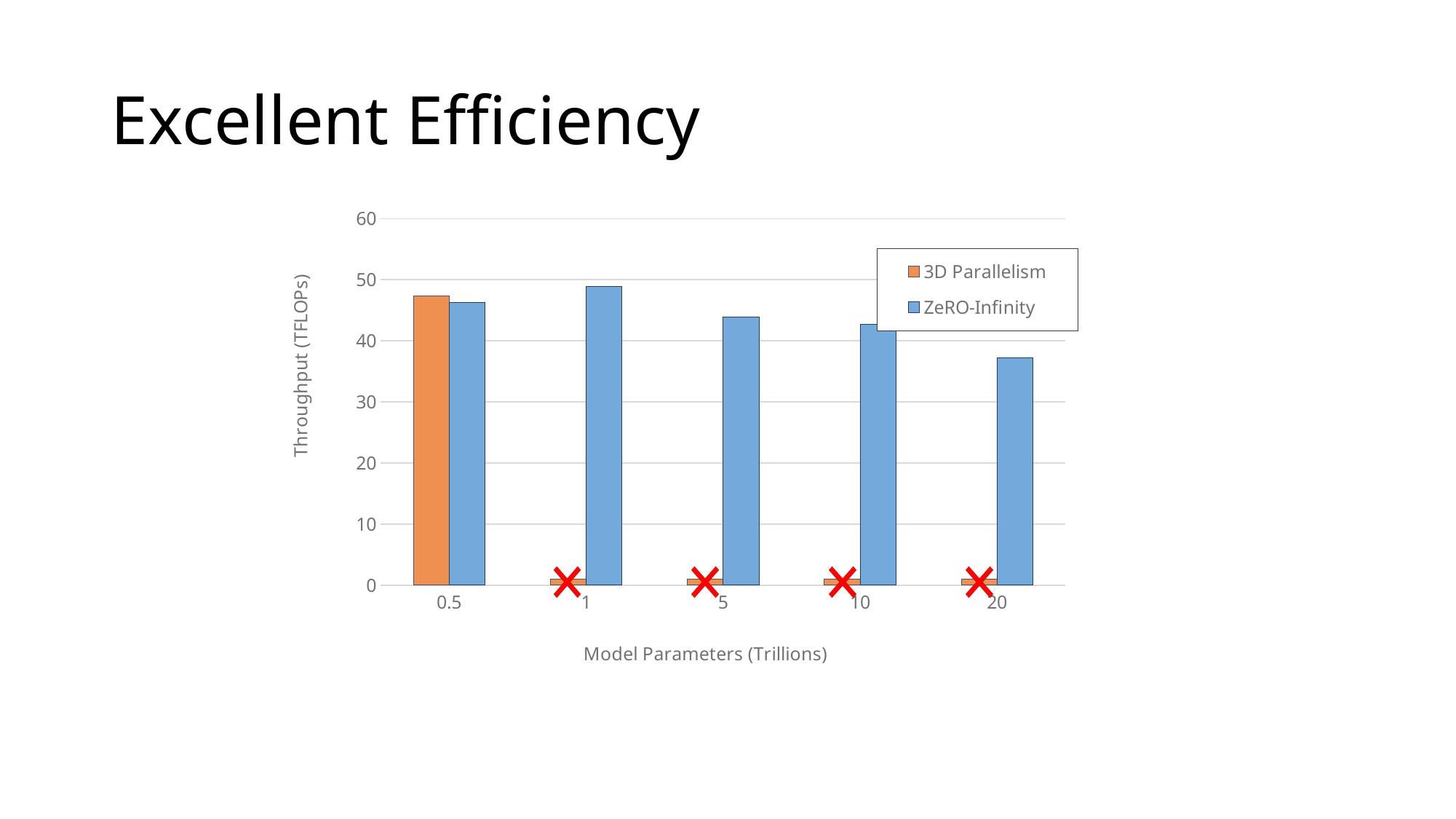
Is the 3D Parallelism throughput at 10 trillion parameters greater or less than 10? less How many model parameter categories are shown on the x axis? 5 How many series does the legend list? 2 Is the ZeRO-Infinity throughput at 5 trillion parameters greater or less than 40? greater Is the ZeRO-Infinity throughput at 20 trillion parameters greater or less than 40? less Which is larger at 10 trillion parameters, the 3D Parallelism throughput or the ZeRO-Infinity throughput? ZeRO-Infinity What is the label of the y axis? Throughput (TFLOPs) Which model parameter size has the highest ZeRO-Infinity throughput? 1 What kind of chart is shown on the slide? bar chart Does the ZeRO-Infinity throughput rise or fall as model parameters increase from 1 to 20 trillion? fall Which model parameter size has the lowest ZeRO-Infinity throughput? 20